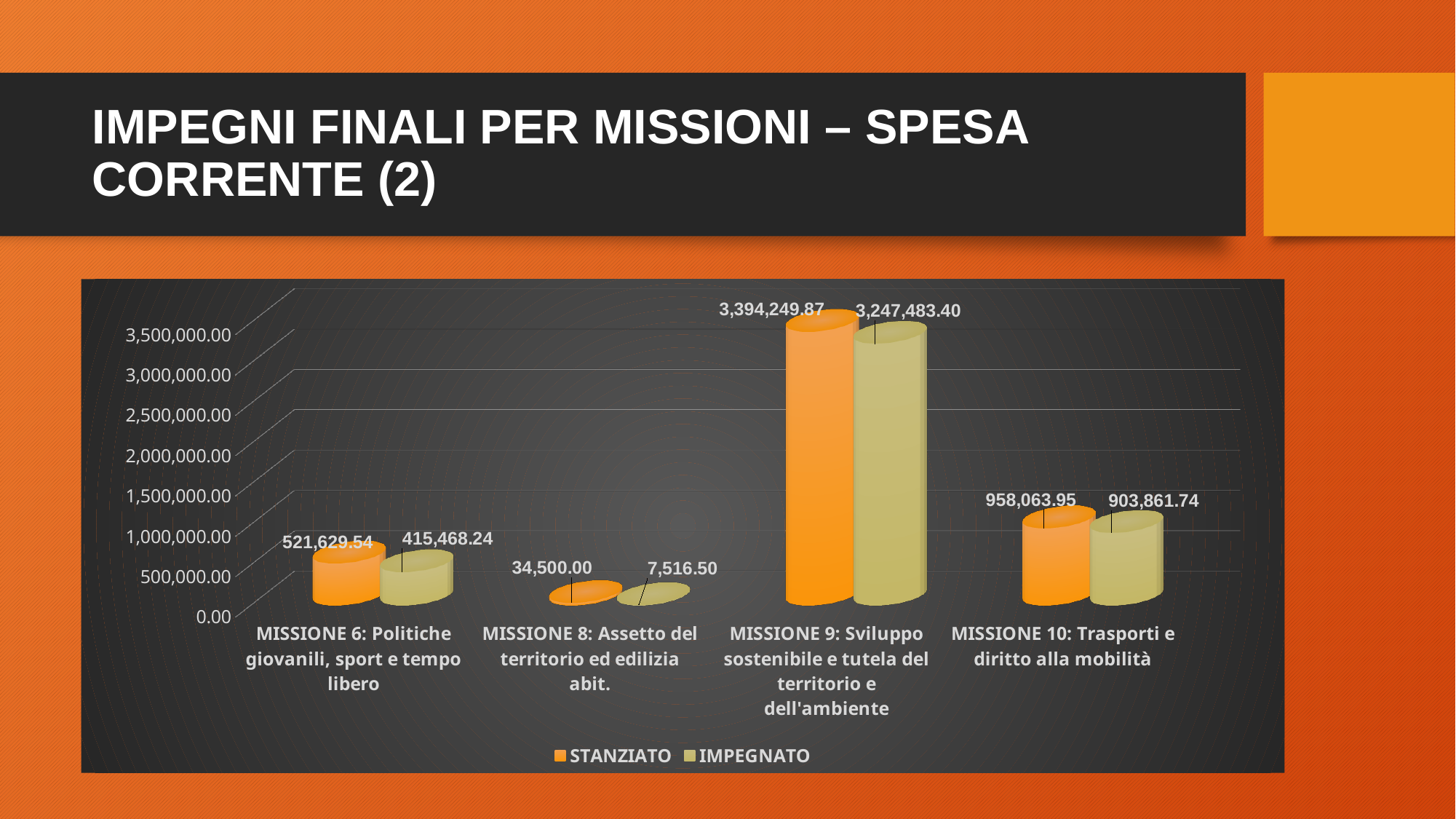
What is the difference between STANZIATO and IMPEGNATO for MISSIONE 8: Assetto del territorio ed edilizia abit.? 26,983.50 What is the STANZIATO value for MISSIONE 9: Sviluppo sostenibile e tutela del territorio e dell'ambiente? 3,394,249.87 Which mission has the lowest STANZIATO value? MISSIONE 8: Assetto del territorio ed edilizia abit. What is the IMPEGNATO value for MISSIONE 6: Politiche giovanili, sport e tempo libero? 415,468.24 Which mission has the highest IMPEGNATO value? MISSIONE 9: Sviluppo sostenibile e tutela del territorio e dell'ambiente What is the IMPEGNATO value for MISSIONE 8: Assetto del territorio ed edilizia abit.? 7,516.50 How many series does the legend list? 2 What kind of chart is shown on the slide? Bar chart Which is larger for MISSIONE 6: the STANZIATO value or the IMPEGNATO value? STANZIATO What is the STANZIATO value for MISSIONE 10: Trasporti e diritto alla mobilità? 958,063.95 How many missions (categories) are shown on the x axis? 4 What is the difference between STANZIATO and IMPEGNATO for MISSIONE 10: Trasporti e diritto alla mobilità? 54,202.21